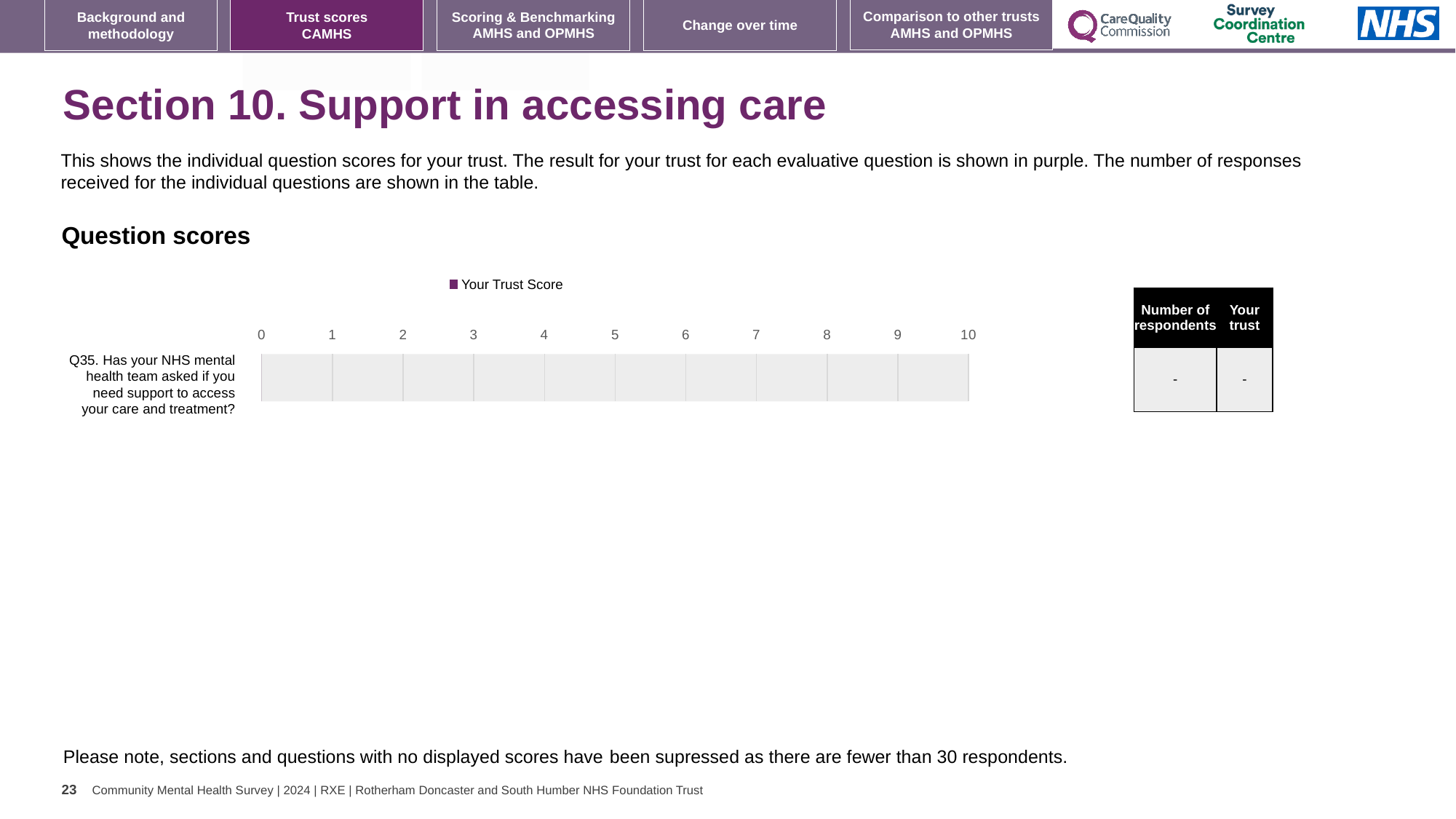
How many series does the legend of the 'Question scores' chart list? 1 What kind of chart is shown under the 'Question scores' heading? bar chart Is a bar plotted for Q35 on the 'Question scores' chart? No What is the highest value shown on the x axis of the 'Question scores' chart? 10 What value is shown in the 'Your trust' column of the table for Q35? - What value is shown in the 'Number of respondents' column of the table for Q35? - What is the name of the series shown in the legend of the 'Question scores' chart? Your Trust Score How many questions (categories) are listed on the 'Question scores' chart? 1